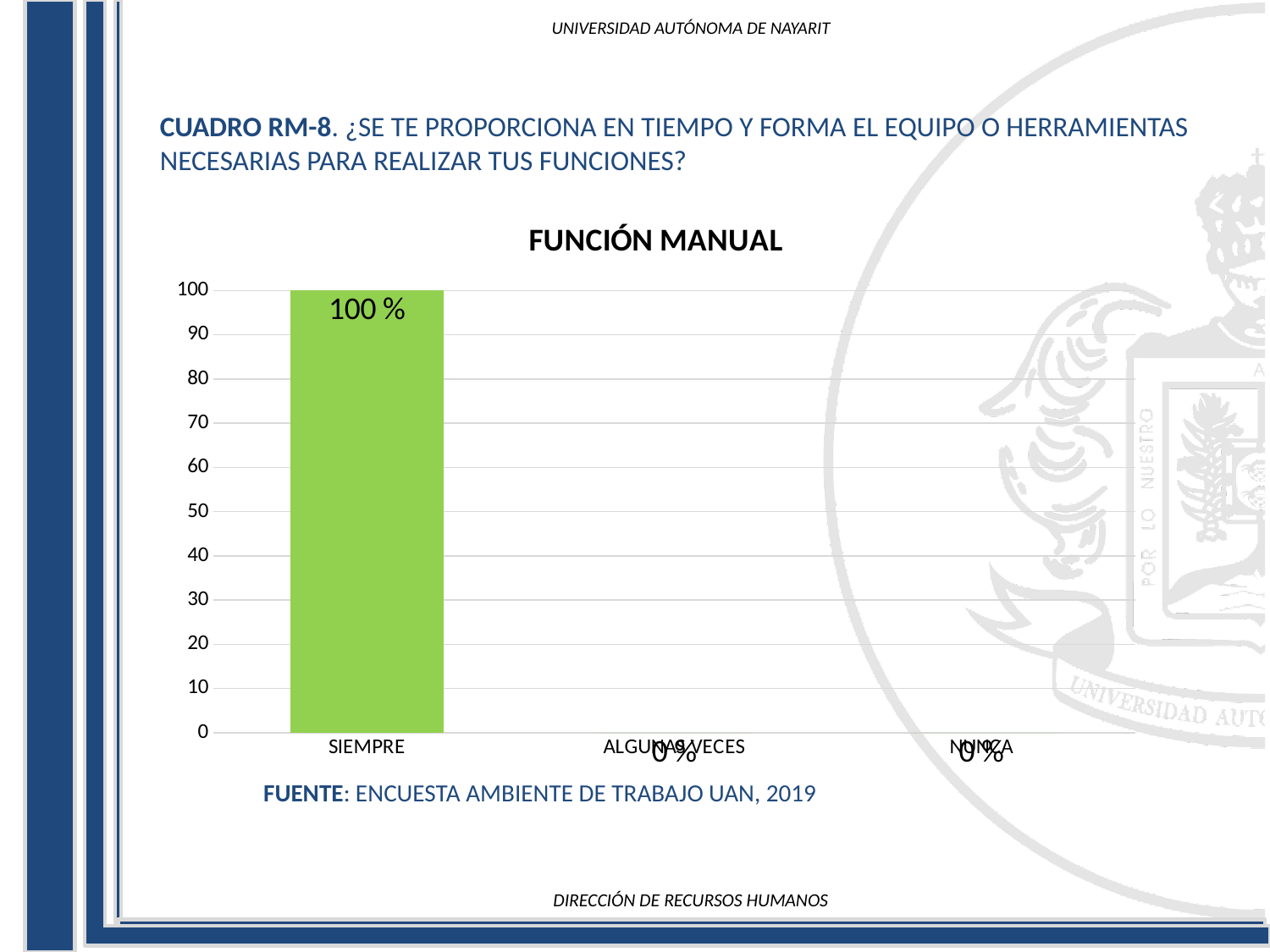
Is the value for SIEMPRE greater or less than 50? greater What is the value for ALGUNAS VECES? 0 % What is the value for NUNCA? 0 % Which category has the highest value? SIEMPRE What is the value for SIEMPRE? 100 % Which is larger, the value for SIEMPRE or the value for ALGUNAS VECES? SIEMPRE What is the highest value shown on the vertical axis? 100 What kind of chart is this? bar chart What is the title of the chart? FUNCIÓN MANUAL Do the values rise or fall from SIEMPRE to NUNCA along the x axis? fall What is the difference between the values for SIEMPRE and NUNCA? 100 % How many categories are shown on the x axis? 3